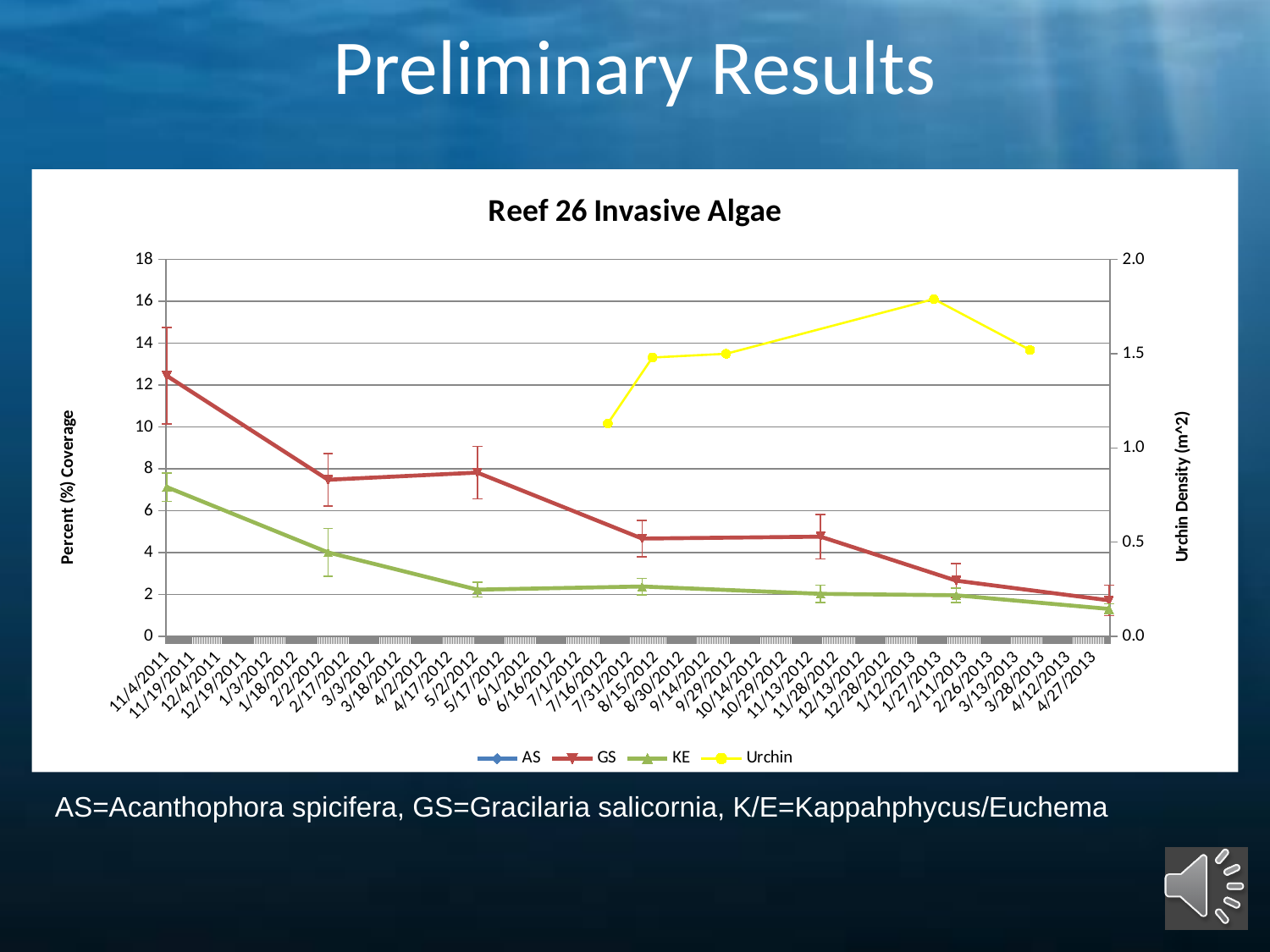
Do the values for GS rise or fall along the x axis from 11/4/2011 to 4/27/2013? fall What kind of chart is shown on the slide? line chart Is the Urchin value at 1/27/2013 greater or less than 1.5? greater Is the Urchin value at 7/16/2012 greater or less than 1.5? less How many series does the legend list? 4 Is the value for GS at 11/4/2011 greater or less than 10? greater What is the title of the chart? Reef 26 Invasive Algae Which series is plotted in yellow? Urchin On which date does the Urchin series reach its highest value? 1/27/2013 Do the values for KE rise or fall along the x axis from 11/4/2011 to 4/27/2013? fall At 11/4/2011, which is larger, the value for GS or the value for KE? GS